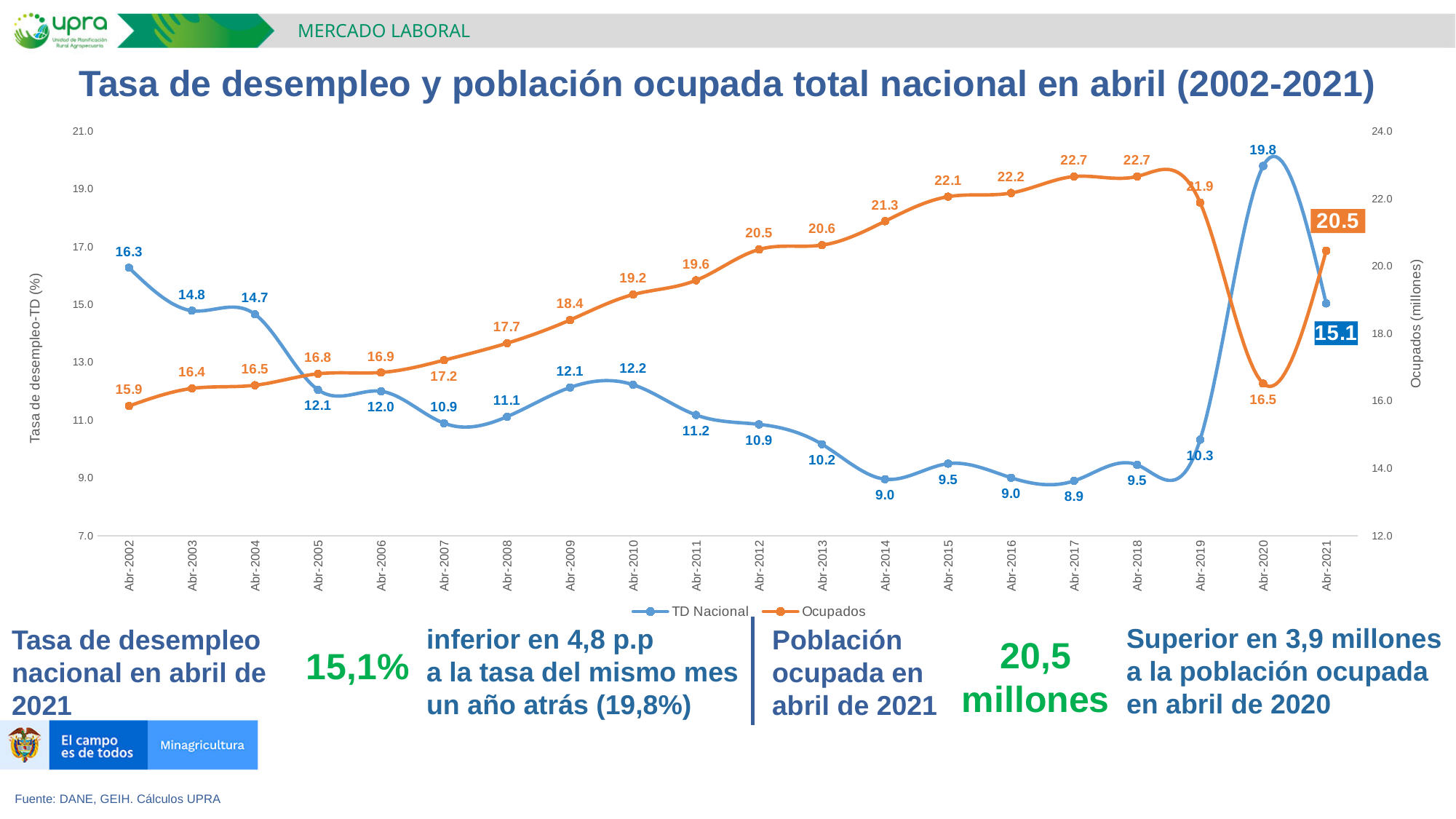
Does the Ocupados series generally rise or fall from Abr-2002 to Abr-2018? Rise In which year does the TD Nacional series reach its highest value? Abr-2020 In which year does the TD Nacional series reach its lowest value? Abr-2017 In which year is the Ocupados series at its lowest value? Abr-2002 How many series does the legend list? 2 What is the Ocupados value for Abr-2014? 21.3 Which is larger, the Ocupados value for Abr-2012 or for Abr-2014? Abr-2014 What type of chart is shown on the slide? Line chart What is the difference between the Ocupados values for Abr-2019 and Abr-2020? 5.4 What is the TD Nacional value for Abr-2002? 16.3 What is the TD Nacional value for Abr-2021? 15.1 How many points (years) are plotted along the x axis? 20